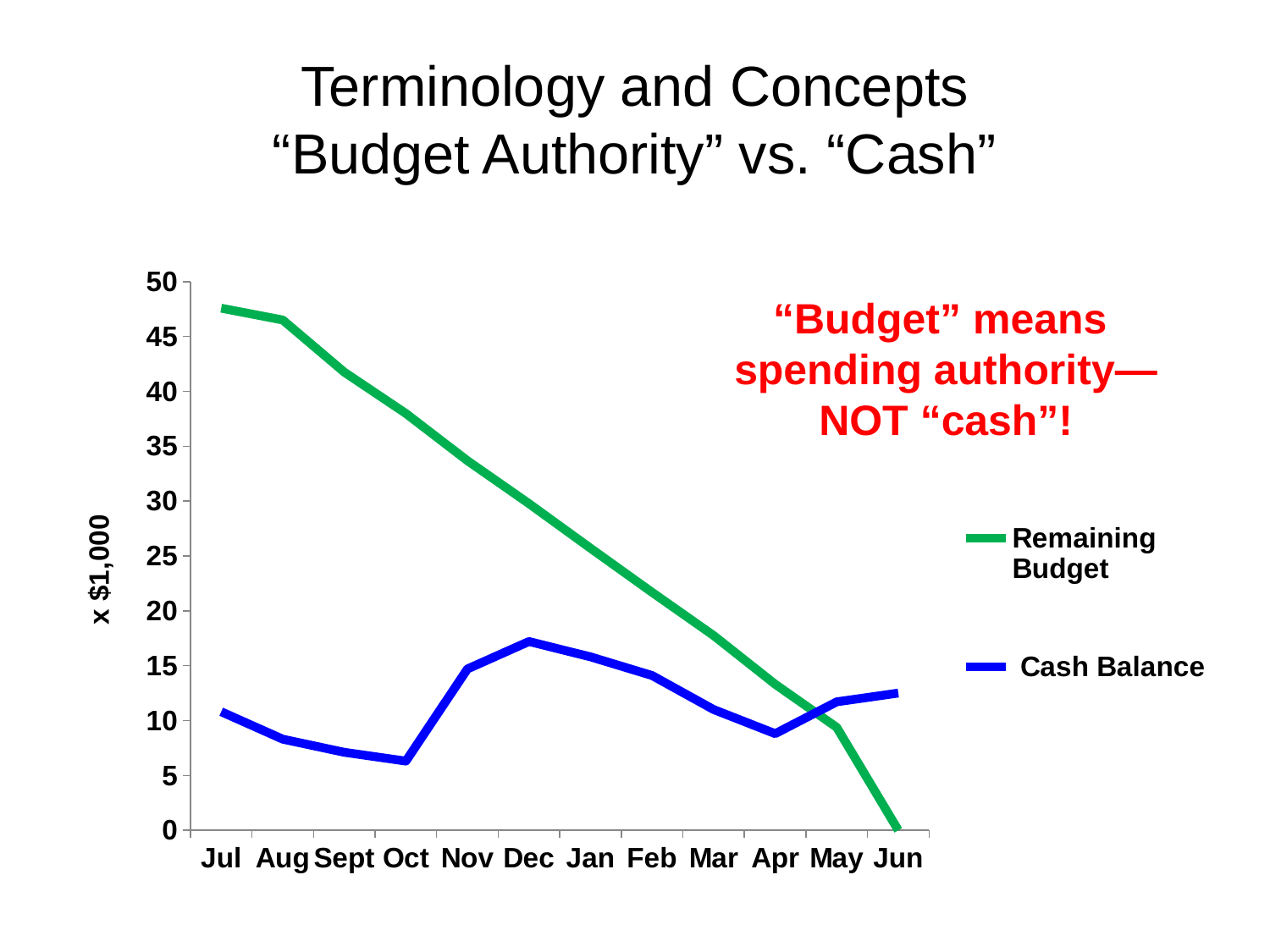
What is the Remaining Budget value in Jun? 0 In which month is the Cash Balance lowest? Oct In Jun, which series has the larger value, Remaining Budget or Cash Balance? Cash Balance Is the Cash Balance value for Oct greater or less than 10? less Does the Remaining Budget line rise or fall from Jul to Jun? fall What is the label on the y axis? x $1,000 Is the Cash Balance value for Dec greater or less than 15? greater How many series does the legend list? 2 Is the Remaining Budget value for Jul greater or less than 45? greater What kind of chart is shown on the slide? line chart How many months are shown along the x axis? 12 In which month is the Cash Balance highest? Dec